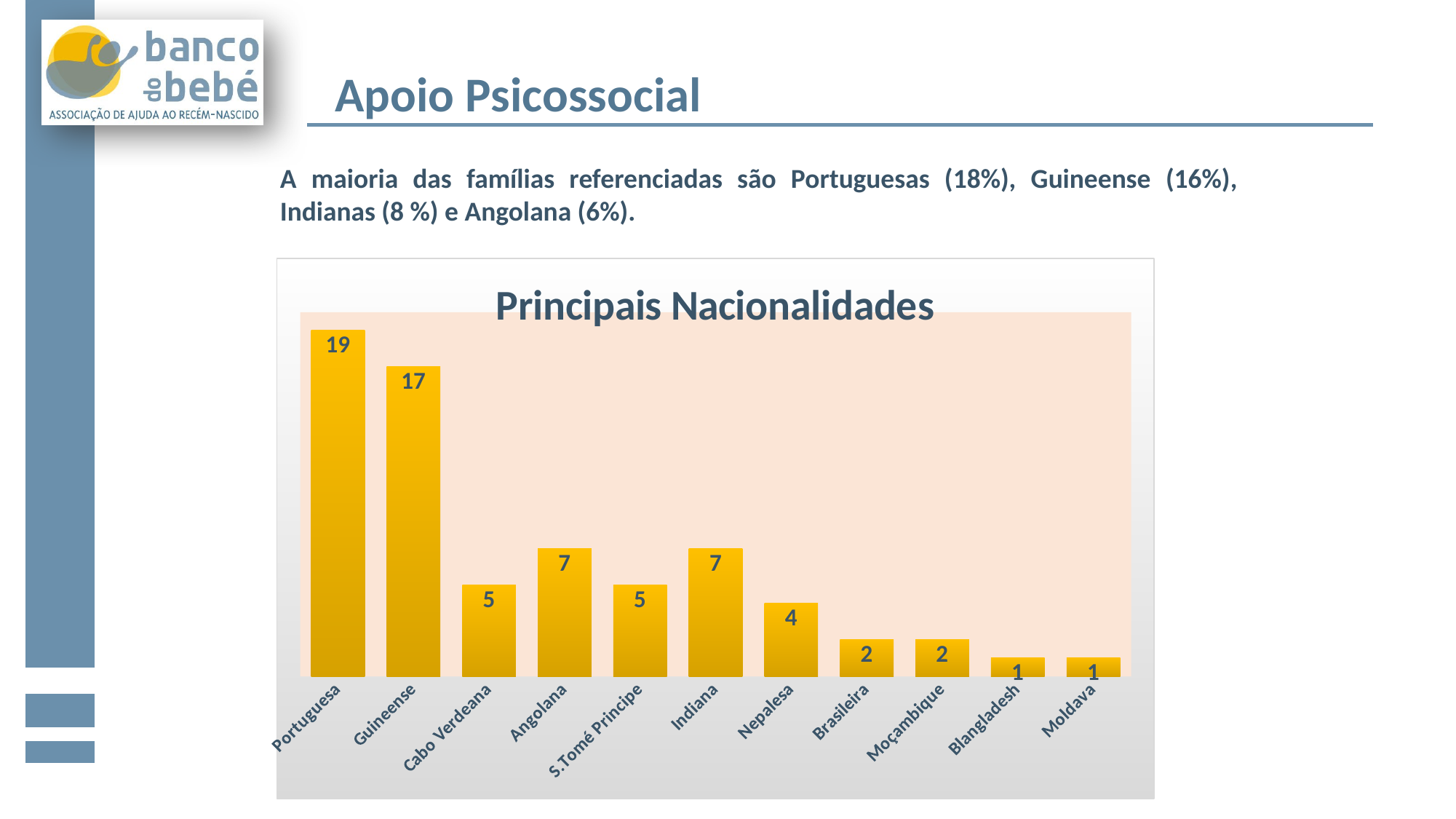
Which nationality has the highest value in the chart? Portuguesa What is the value for Portuguesa in the Principais Nacionalidades chart? 19 What kind of chart is shown on the slide? Bar chart What is the value for Nepalesa? 4 How many nationalities are shown in the chart? 11 Which is larger, the value for Brasileira or the value for Cabo Verdeana? Cabo Verdeana What is the value for Moçambique? 2 What is the difference between the values for Portuguesa and Guineense? 2 What is the value for Guineense? 17 What is the difference between the values for Angolana and Cabo Verdeana? 2 What is the title of the chart? Principais Nacionalidades Which is larger, the value for Indiana or the value for Nepalesa? Indiana